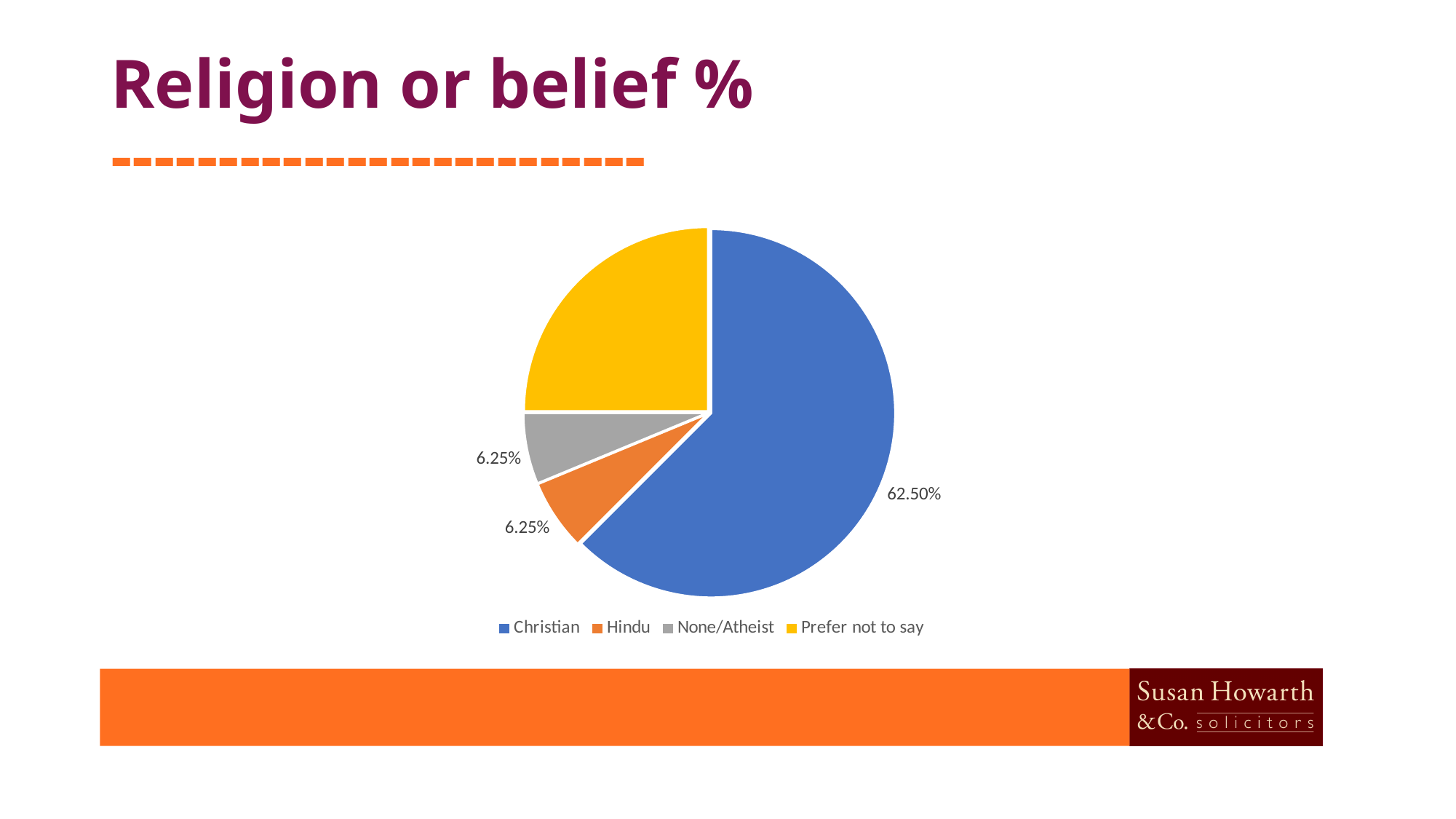
Which category has the largest slice of the pie? Christian Which slice is larger: Christian or Prefer not to say? Christian What kind of chart is shown on the slide? pie chart What percentage of the pie is labelled for None/Atheist? 6.25% What percentage of the pie is labelled for Christian? 62.50% What is the title of the chart on the slide? Religion or belief % What colour is the Prefer not to say slice in the pie chart? yellow How many categories does the pie chart show? 4 Is the Christian share greater or less than 50%? greater Which slice is larger: Prefer not to say or Hindu? Prefer not to say What is the difference between the Christian share and the Hindu share? 56.25% What percentage of the pie is labelled for Hindu? 6.25%